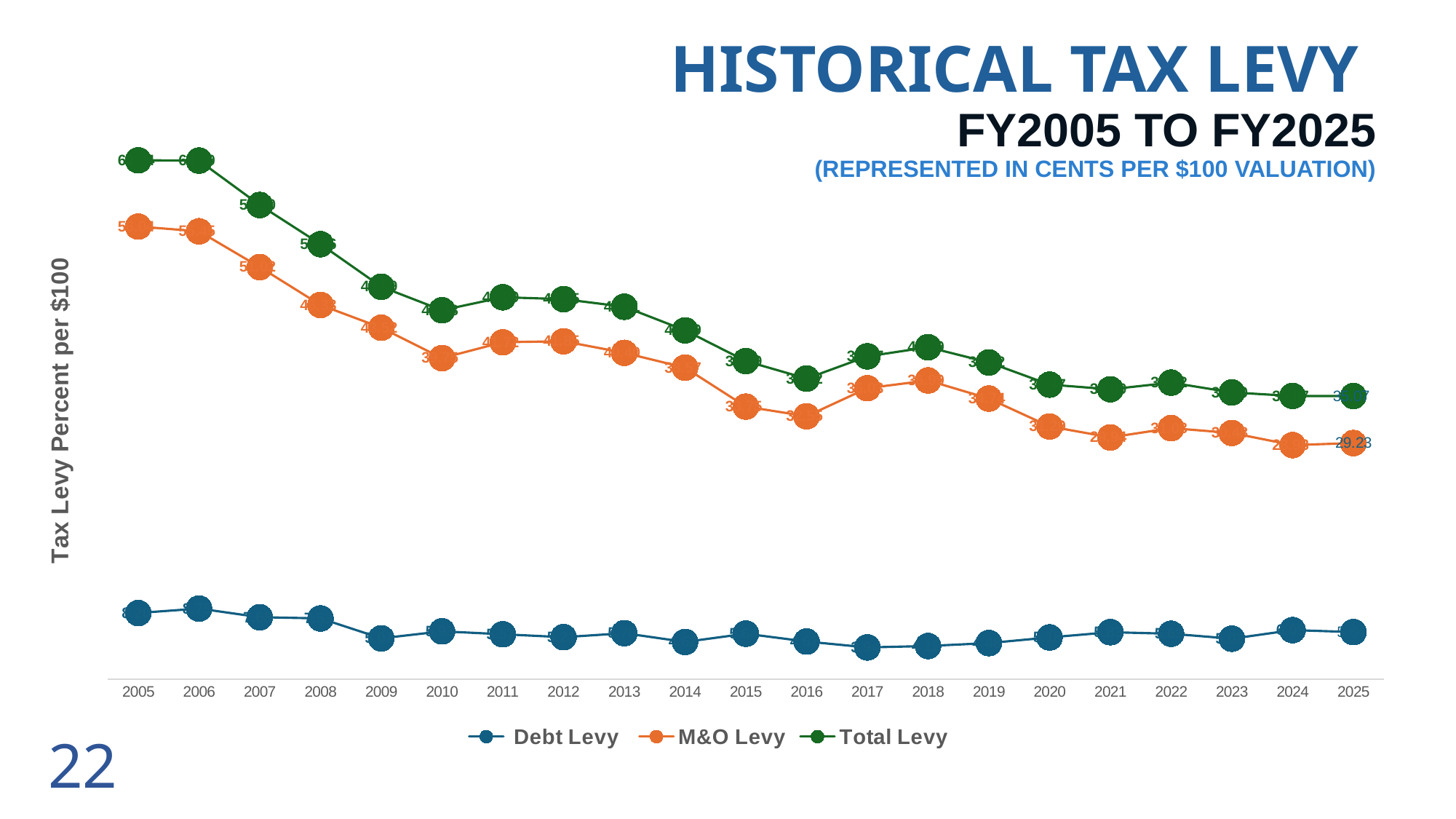
Which series has the lowest values across all years? Debt Levy What is the M&O Levy value for 2025? 29.23 What kind of chart is shown on the slide? Line chart Does the Total Levy rise or fall from 2005 to 2009? Fall How many years are plotted along the x axis? 21 How many series does the legend list? 3 Which colour represents the Total Levy series? Green What is the title of the chart? Historical Tax Levy FY2005 to FY2025 Does the Total Levy generally rise or fall from 2005 to 2025? Fall Does the M&O Levy rise or fall from 2016 to 2018? Rise Which is larger, the Debt Levy in 2006 or the Debt Levy in 2017? 2006 Which is larger in 2015, the Total Levy or the M&O Levy? Total Levy